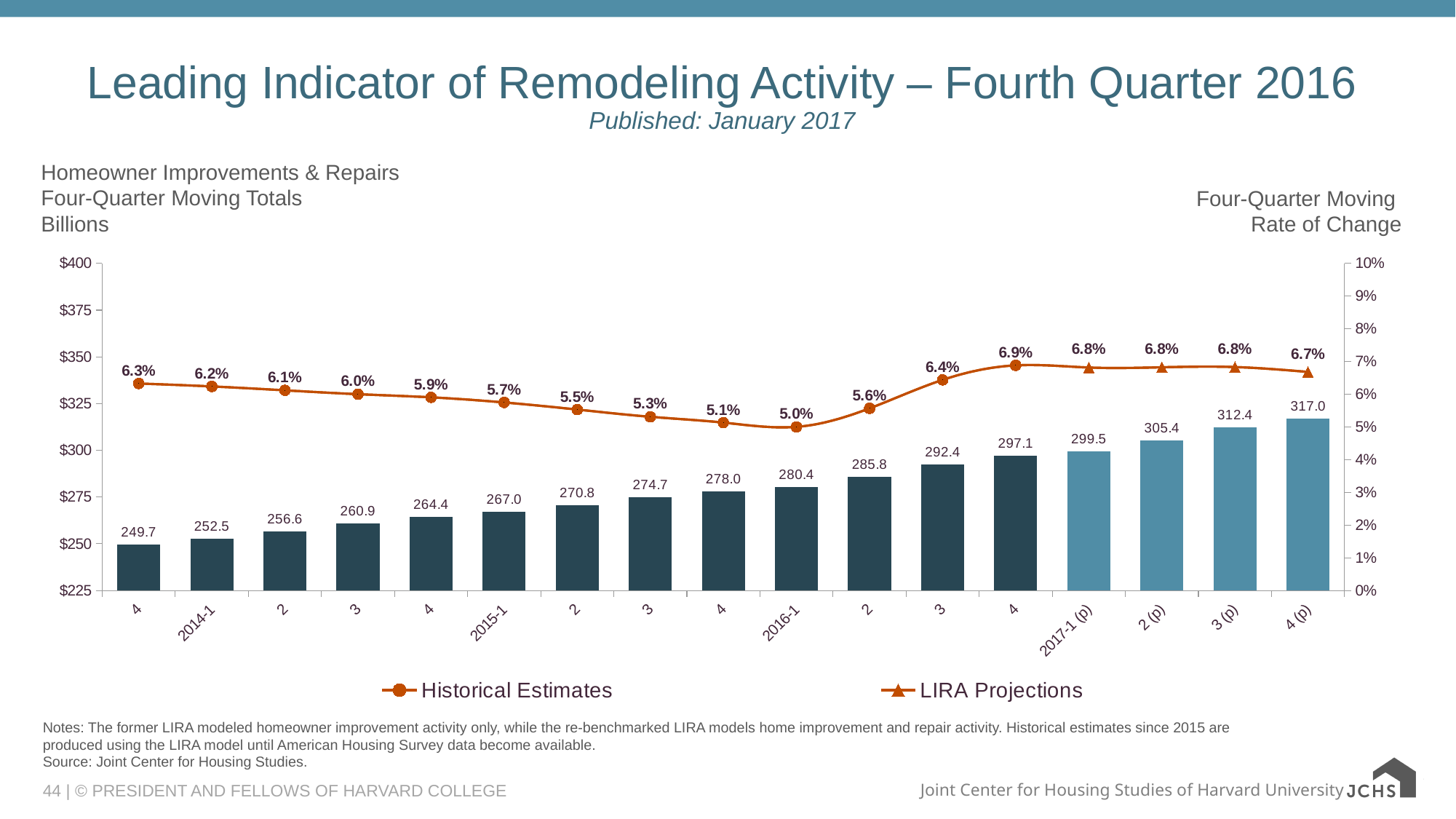
What is the four-quarter moving rate of change shown for 2017-1 (p)? 6.8% Is the four-quarter moving total for 2015-1 larger or smaller than the total for 2016-1? smaller Do the four-quarter moving totals (bars) rise or fall from left to right across the chart? rise What is the difference between the rate of change at 2016 quarter 4 (6.9%) and at 2016-1 (5.0%)? 1.9 percentage points What is the four-quarter moving total (in billions) for 2016-1? 280.4 Which bar has the lowest four-quarter moving total? The first bar (quarter 4, 249.7) Which quarter has the highest four-quarter moving rate of change on the line? 2016 quarter 4 How many series does the legend list? 2 How many bars (quarters) are plotted on the chart? 17 What is the four-quarter moving total (in billions) for 4 (p) in 2017? 317.0 What is the difference in four-quarter moving totals between 4 (p) of 2017 and 2017-1 (p)? 17.5 Which quarter has the lowest four-quarter moving rate of change on the line? 2016-1